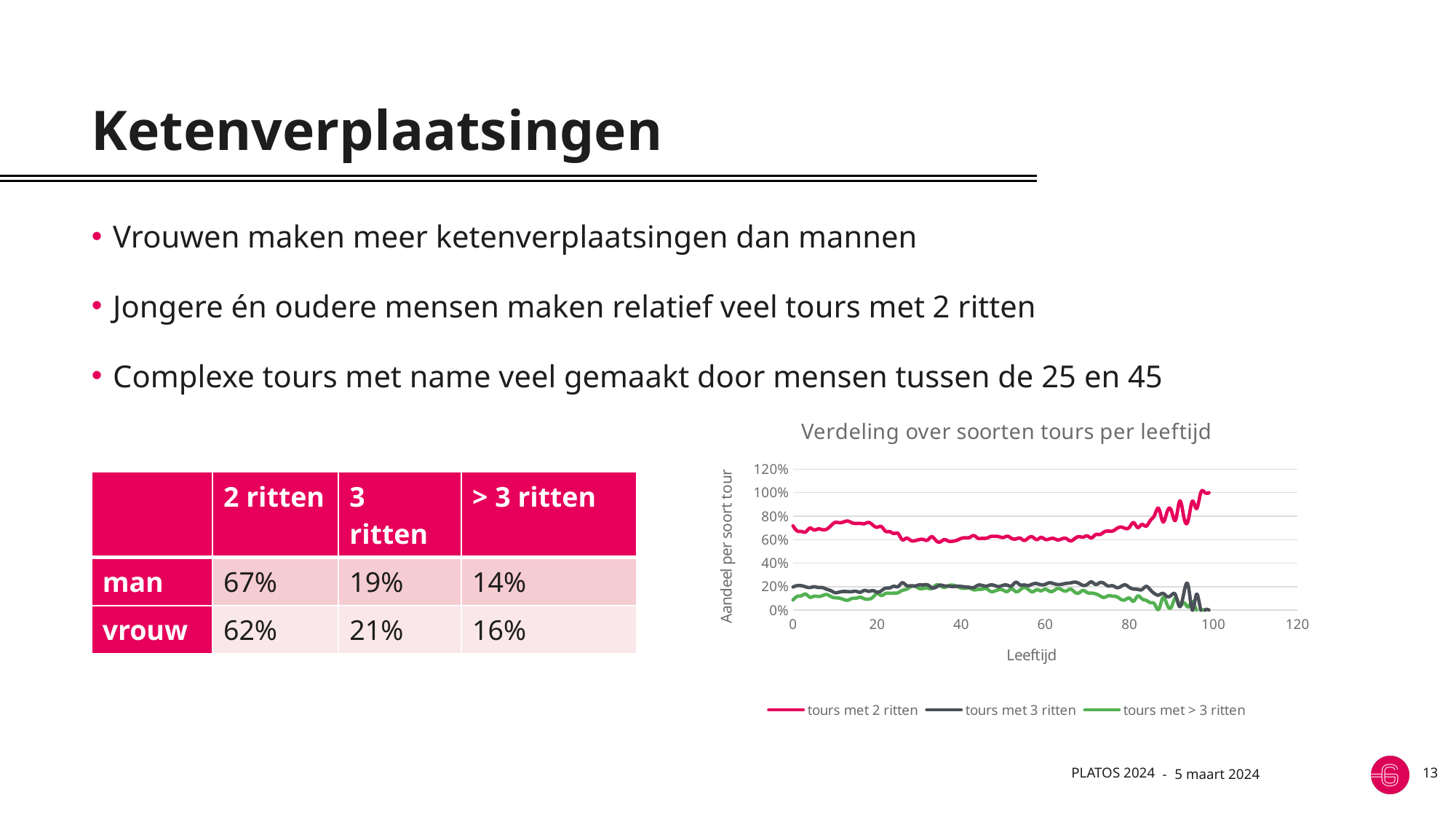
Is the value for tours met 2 ritten at age 95 greater or less than 60%? greater Which series has the lowest value at age 10? tours met > 3 ritten What kind of chart is shown on the slide? line chart Is the value for tours met 3 ritten at age 10 greater or less than 40%? less Which series has the highest values across all ages in the chart? tours met 2 ritten Is the value for tours met 2 ritten at age 20 greater or less than 60%? greater What is the label of the x axis of the chart? Leeftijd At age 20, which series has the higher value: tours met 2 ritten or tours met 3 ritten? tours met 2 ritten What is the title of the chart? Verdeling over soorten tours per leeftijd How many series does the legend of the chart list? 3 Does the value for tours met 2 ritten rise or fall between age 60 and age 100? rise